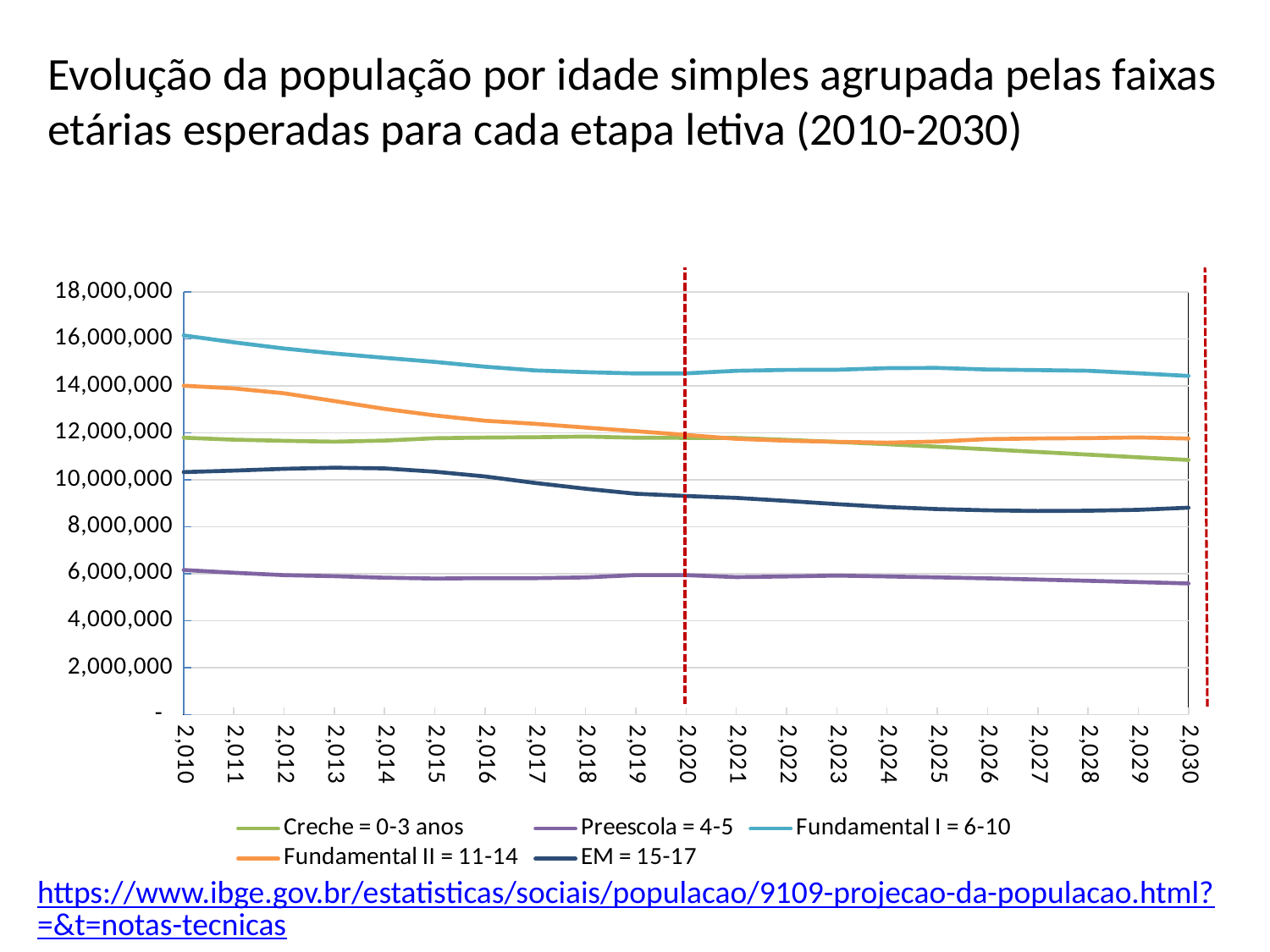
What kind of chart is shown on the slide? Line chart In 2010, which is larger: Fundamental II = 11-14 or Creche = 0-3 anos? Fundamental II = 11-14 At which two years are the vertical red dashed lines placed? 2020 and 2030 Is the value for Creche = 0-3 anos in 2030 greater or less than 10,000,000? greater Which series has the highest values across the whole period? Fundamental I = 6-10 How many series does the legend list? 5 Is the value for EM = 15-17 in 2030 greater or less than 10,000,000? less Does the Fundamental I = 6-10 line rise or fall from 2010 to 2030? Fall Is the value for Fundamental I = 6-10 in 2030 greater or less than 16,000,000? less How many years are plotted along the x axis? 21 Which series has the lowest values across the whole period? Preescola = 4-5 Does the Fundamental II = 11-14 line rise or fall from 2010 to 2020? Fall